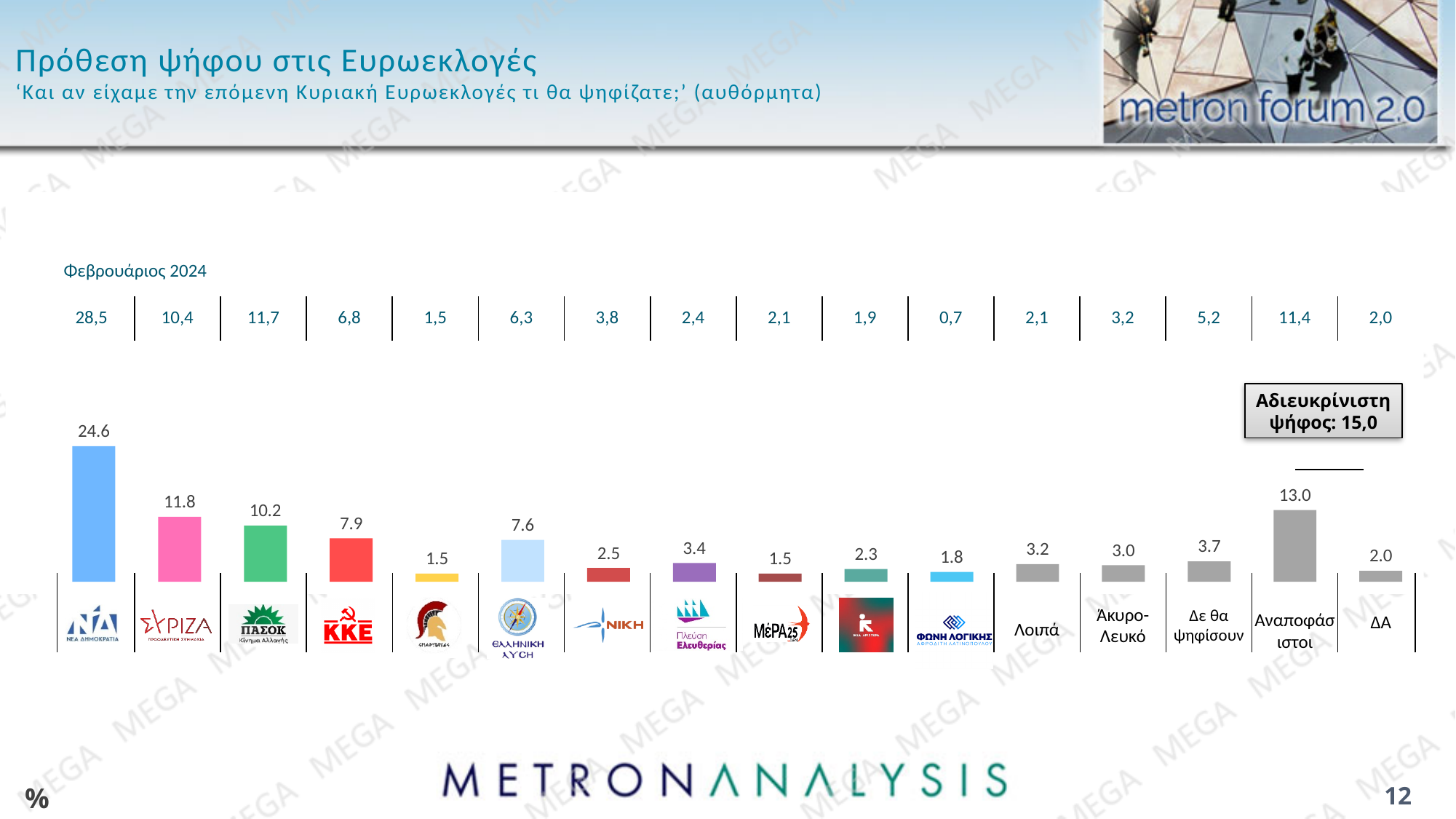
What is the value shown for Αναποφάσιστοι in the bar chart? 13.0 What value is given for Αδιευκρίνιστη ψήφος in the box on the chart? 15,0 What is the difference between the values for ΣΥΡΙΖΑ and ΠΑΣΟΚ? 1.6 How many bars are plotted in the chart? 16 What kind of chart is shown on the slide? Bar chart What is the value shown for ΝΕΑ ΔΗΜΟΚΡΑΤΙΑ in the bar chart? 24.6 Which is larger, the value for ΚΚΕ or the value for ΕΛΛΗΝΙΚΗ ΛΥΣΗ? ΚΚΕ What is the difference between the values for ΝΕΑ ΔΗΜΟΚΡΑΤΙΑ and ΣΥΡΙΖΑ? 12.8 What is the value shown for Πλεύση Ελευθερίας in the bar chart? 3.4 What is the value shown for ΠΑΣΟΚ in the bar chart? 10.2 Which is larger, the value for Δε θα ψηφίσουν or the value for Άκυρο-Λευκό? Δε θα ψηφίσουν Which category has the highest bar in the chart? ΝΕΑ ΔΗΜΟΚΡΑΤΙΑ